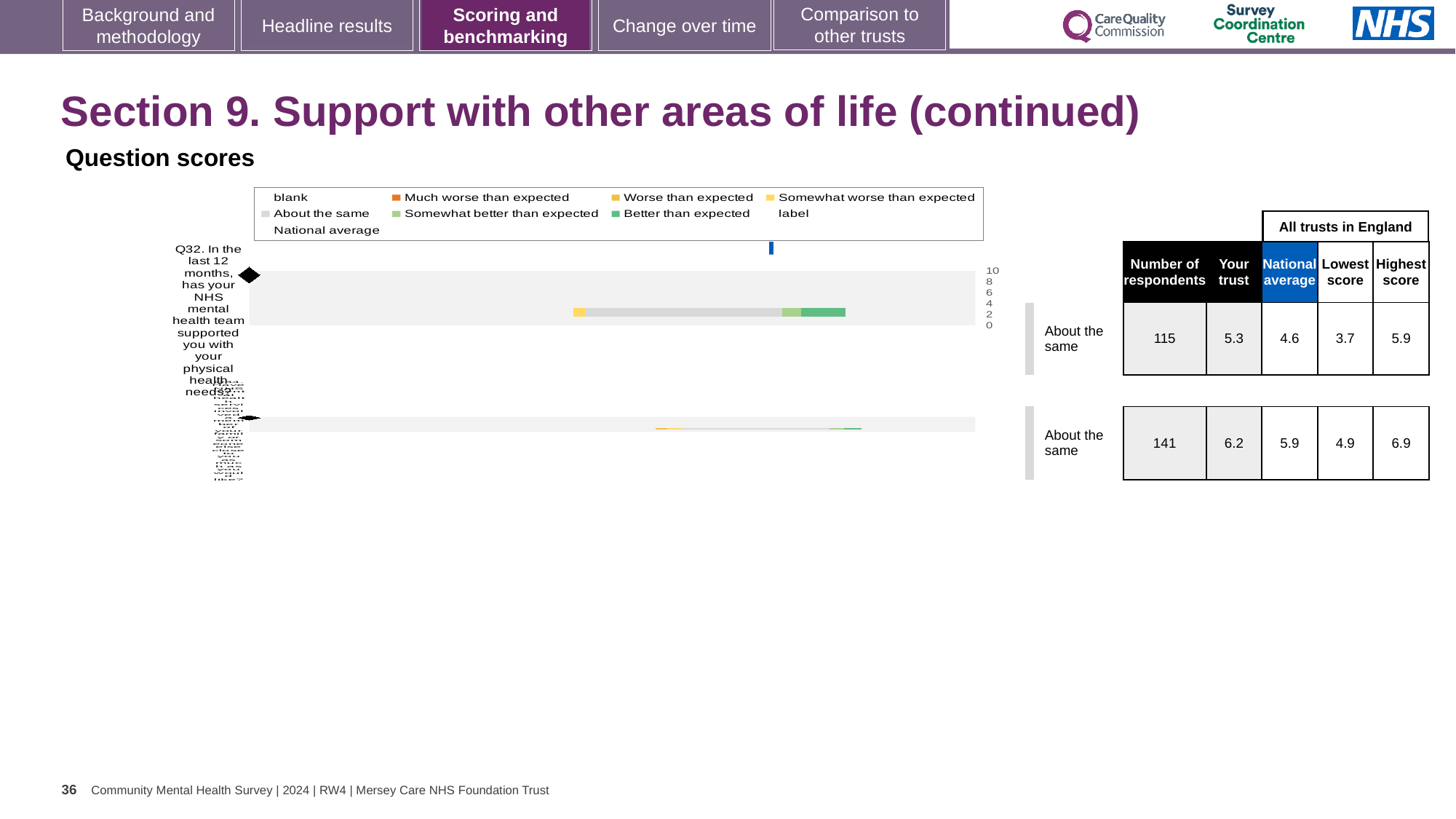
For Q32, which is larger: the trust's score or the national average? Your trust (5.3) How many respondents answered Q32? 115 What is the highest score among all trusts in England for Q32? 5.9 What kind of chart is shown on the slide? bar chart By how much does the trust's score for Q32 exceed the national average? 0.7 What is the lowest score among all trusts in England for Q32? 3.7 In the table, what is the number of respondents shown in the second (lower) row? 141 What is the national average score for Q32? 4.6 What is the difference between the highest and lowest scores for Q32? 2.2 What is the 'Your trust' score for Q32 (support with physical health needs)? 5.3 How is the trust's result for Q32 categorised relative to expectations? About the same How many question rows are plotted on the chart? 2